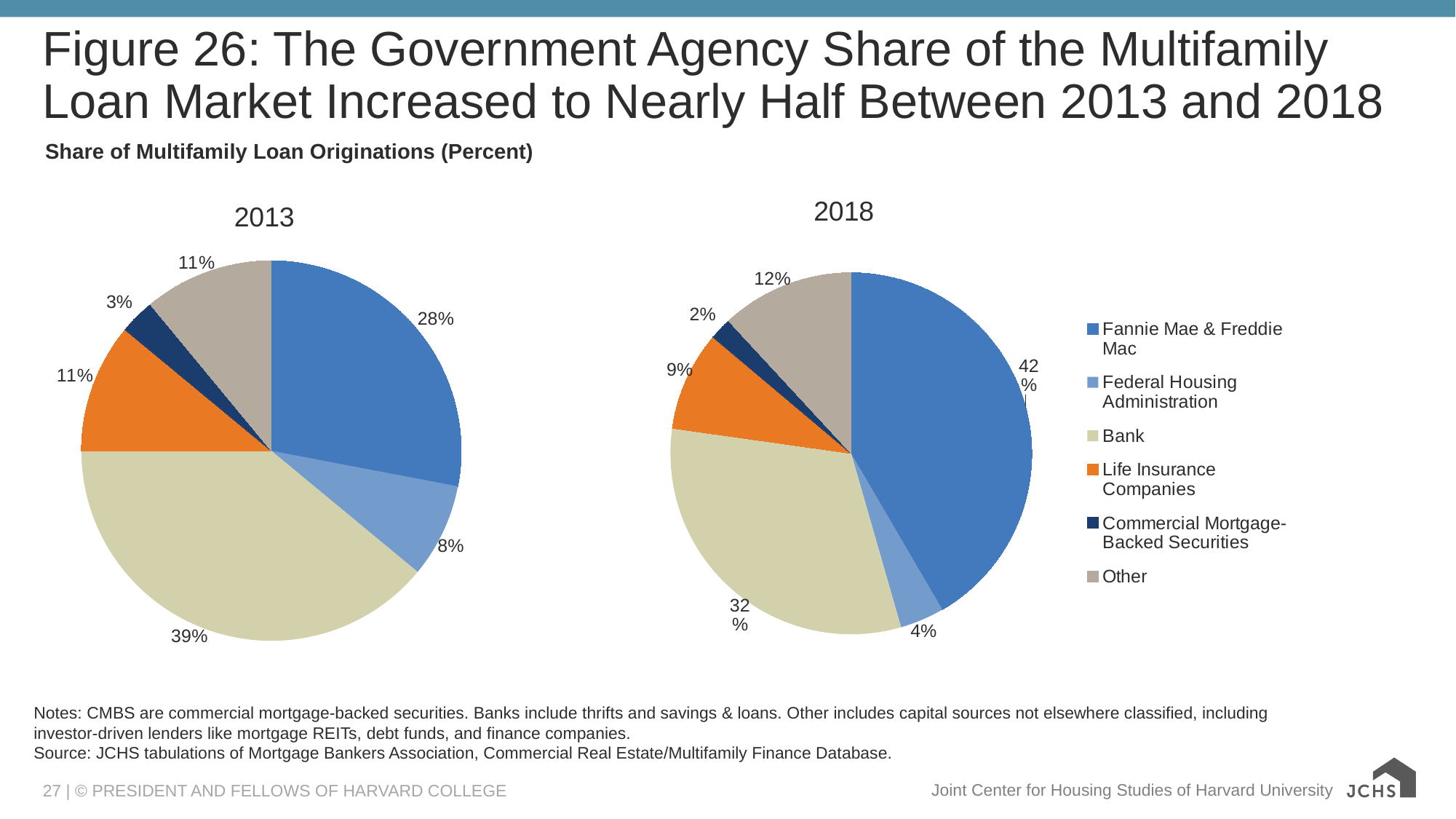
How much larger is the Fannie Mae & Freddie Mac share in the 2018 pie chart than in the 2013 pie chart? 14 percentage points In the 2013 pie chart, which category has the largest share? Bank How many categories does the legend list? 6 In the 2018 pie chart, which category has the largest share? Fannie Mae & Freddie Mac In the 2013 pie chart, what share do Fannie Mae & Freddie Mac hold? 28% In the 2018 pie chart, what is the share for Federal Housing Administration? 4% In the 2018 pie chart, what share do Fannie Mae & Freddie Mac hold? 42% In the 2018 pie chart, what is the share for Other? 12% In the 2013 pie chart, which is larger: the share for Life Insurance Companies or the share for Federal Housing Administration? Life Insurance Companies In the 2018 pie chart, which category has the smallest share? Commercial Mortgage-Backed Securities What kind of charts are shown on the slide? Pie charts In the 2013 pie chart, what is the share for Bank? 39%